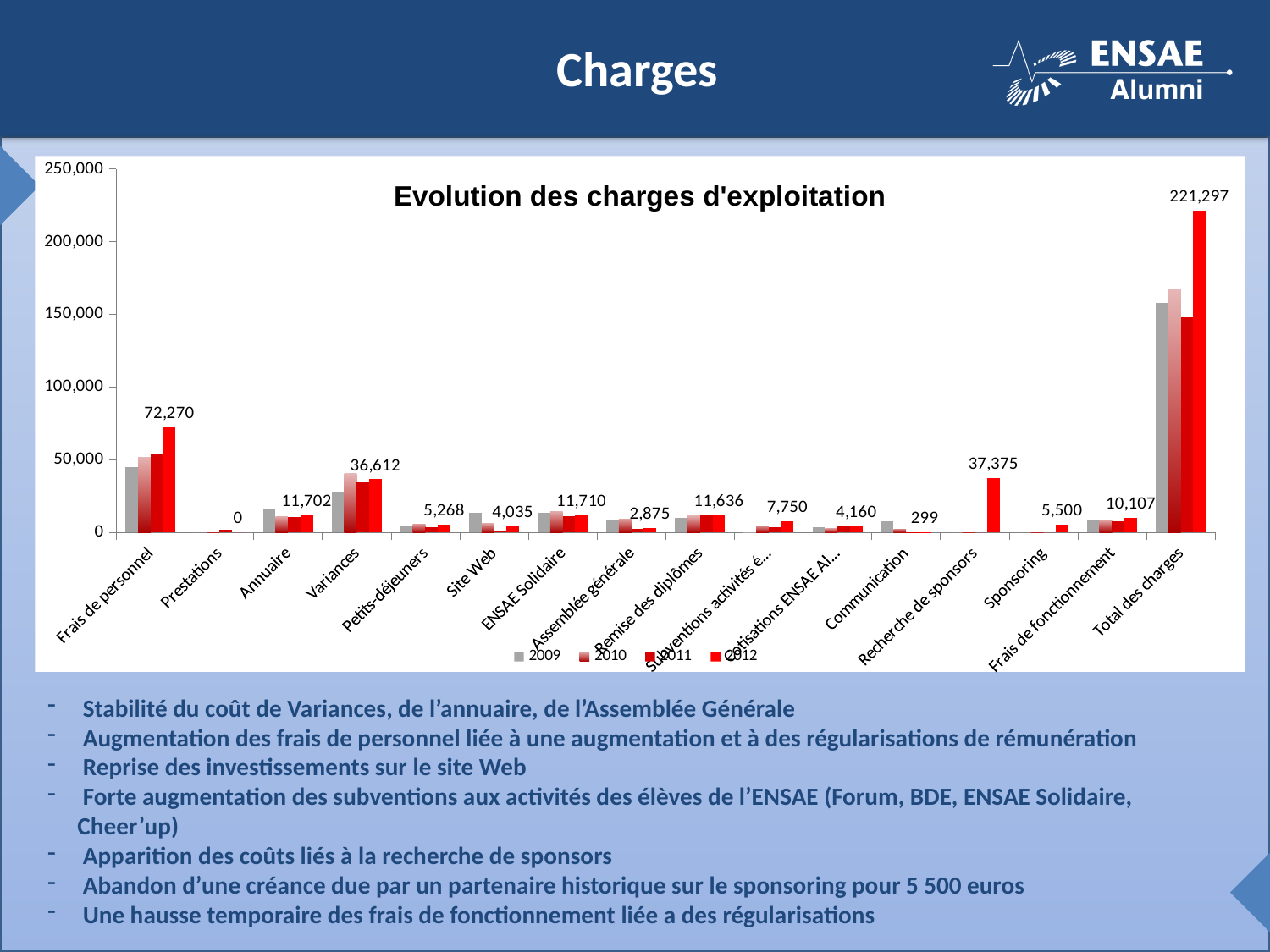
Is the 2012 value for Frais de personnel greater or less than 50,000? greater How many categories are shown on the x axis of the chart? 16 What is the difference between the 2012 values for Frais de personnel and Variances? 35,658 Which category has the lowest 2012 value? Prestations What is the 2012 value for Recherche de sponsors? 37,375 How many series does the chart legend list? 4 What is the 2012 value for Total des charges? 221,297 Which category has the highest 2012 value? Total des charges What kind of chart is shown on the slide? bar chart What is the 2012 value for Sponsoring? 5,500 What is the 2012 value for Frais de personnel? 72,270 What is the title of the chart? Evolution des charges d'exploitation